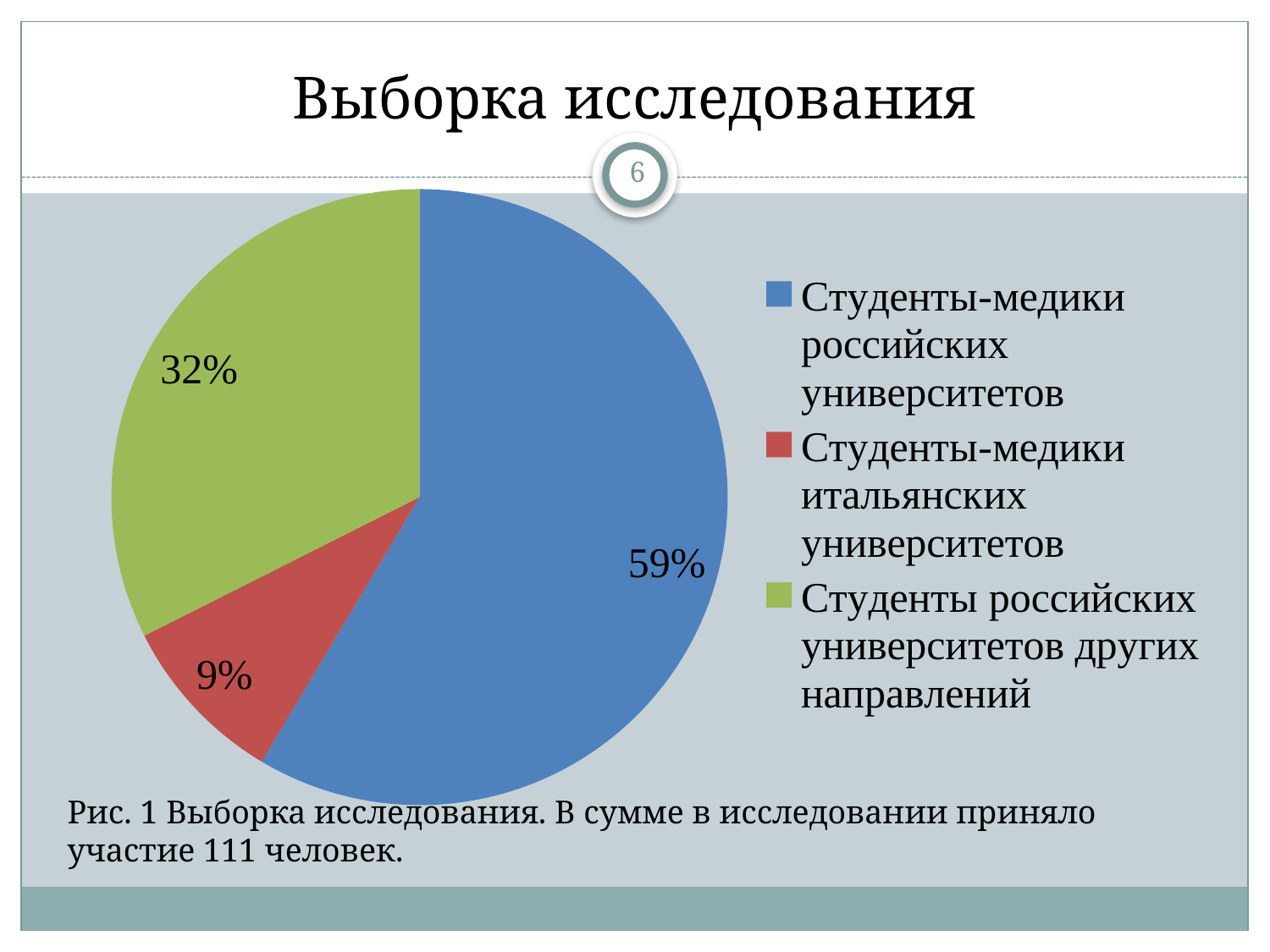
What is the difference in percentage points between the slice for 'Студенты российских университетов других направлений' and the slice for 'Студенты-медики итальянских университетов'? 23 What is the difference in percentage points between the slice for 'Студенты-медики российских университетов' and the slice for 'Студенты российских университетов других направлений'? 27 What share of the pie is labelled for 'Студенты-медики итальянских университетов'? 9% How many categories does the pie chart show? 3 Which category has the smallest slice of the pie? Студенты-медики итальянских университетов What share of the pie is labelled for 'Студенты российских университетов других направлений'? 32% Which slice is larger: 'Студенты-медики итальянских университетов' or 'Студенты российских университетов других направлений'? Студенты российских университетов других направлений What colour is the slice for 'Студенты-медики итальянских университетов'? red What is the title of the slide containing the chart? Выборка исследования Which category has the largest slice of the pie? Студенты-медики российских университетов What share of the pie is labelled for 'Студенты-медики российских университетов'? 59% What kind of chart is shown on the slide? pie chart